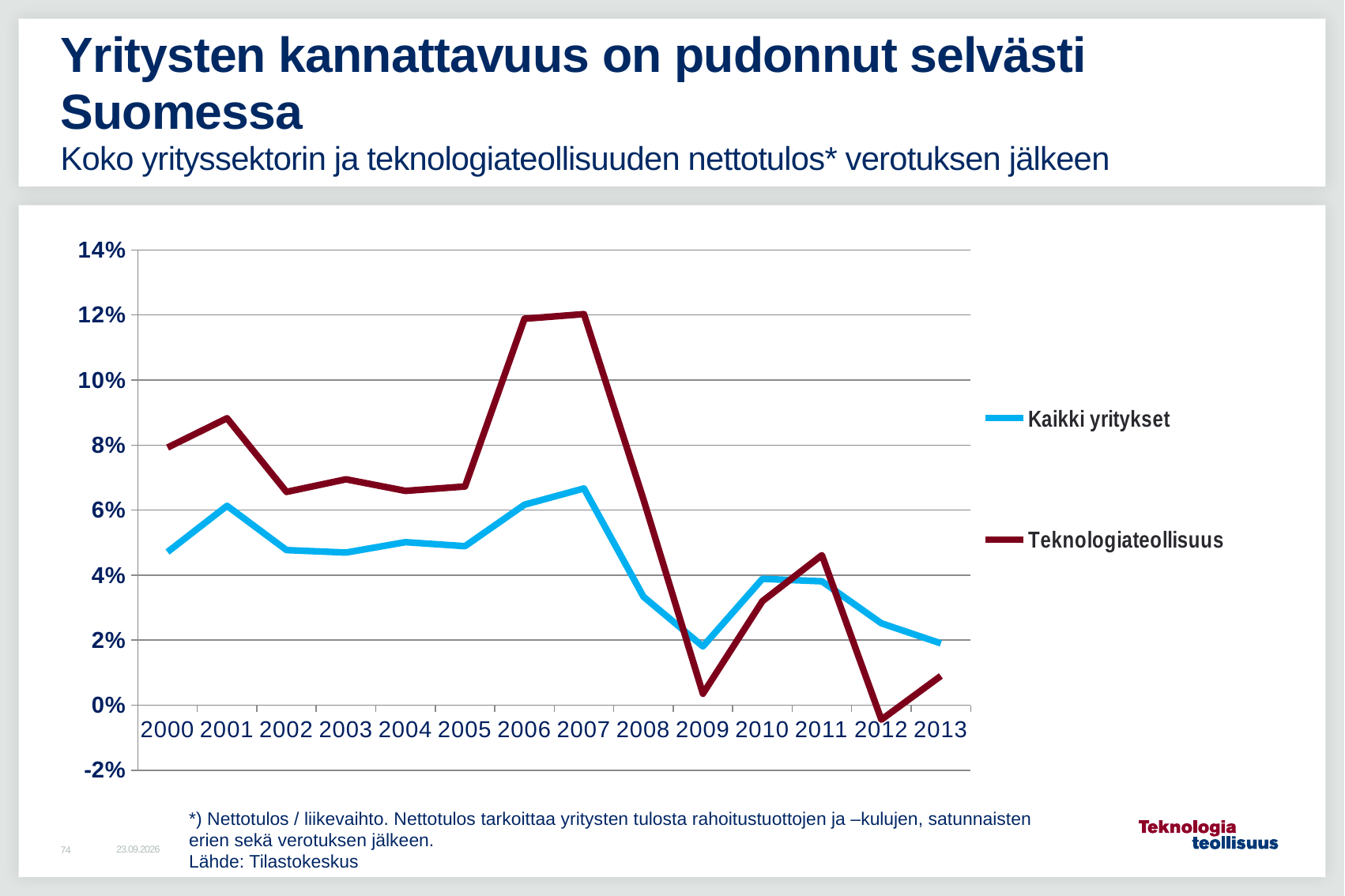
Is the value for Kaikki yritykset in 2008 greater or less than 4%? less Does the Teknologiateollisuus series rise or fall from 2007 to 2009? fall In which year does the Teknologiateollisuus series reach its lowest value? 2012 Which series has the higher value in 2000, Kaikki yritykset or Teknologiateollisuus? Teknologiateollisuus Is the value for Teknologiateollisuus in 2007 greater or less than 10%? greater In which year does the Kaikki yritykset series reach its highest value? 2007 What kind of chart is shown on the slide? line chart Is the value for Teknologiateollisuus in 2012 greater or less than 0%? less Which series is drawn in light blue? Kaikki yritykset How many years are plotted along the x axis? 14 Which series has the higher value in 2009, Kaikki yritykset or Teknologiateollisuus? Kaikki yritykset How many series does the legend list? 2